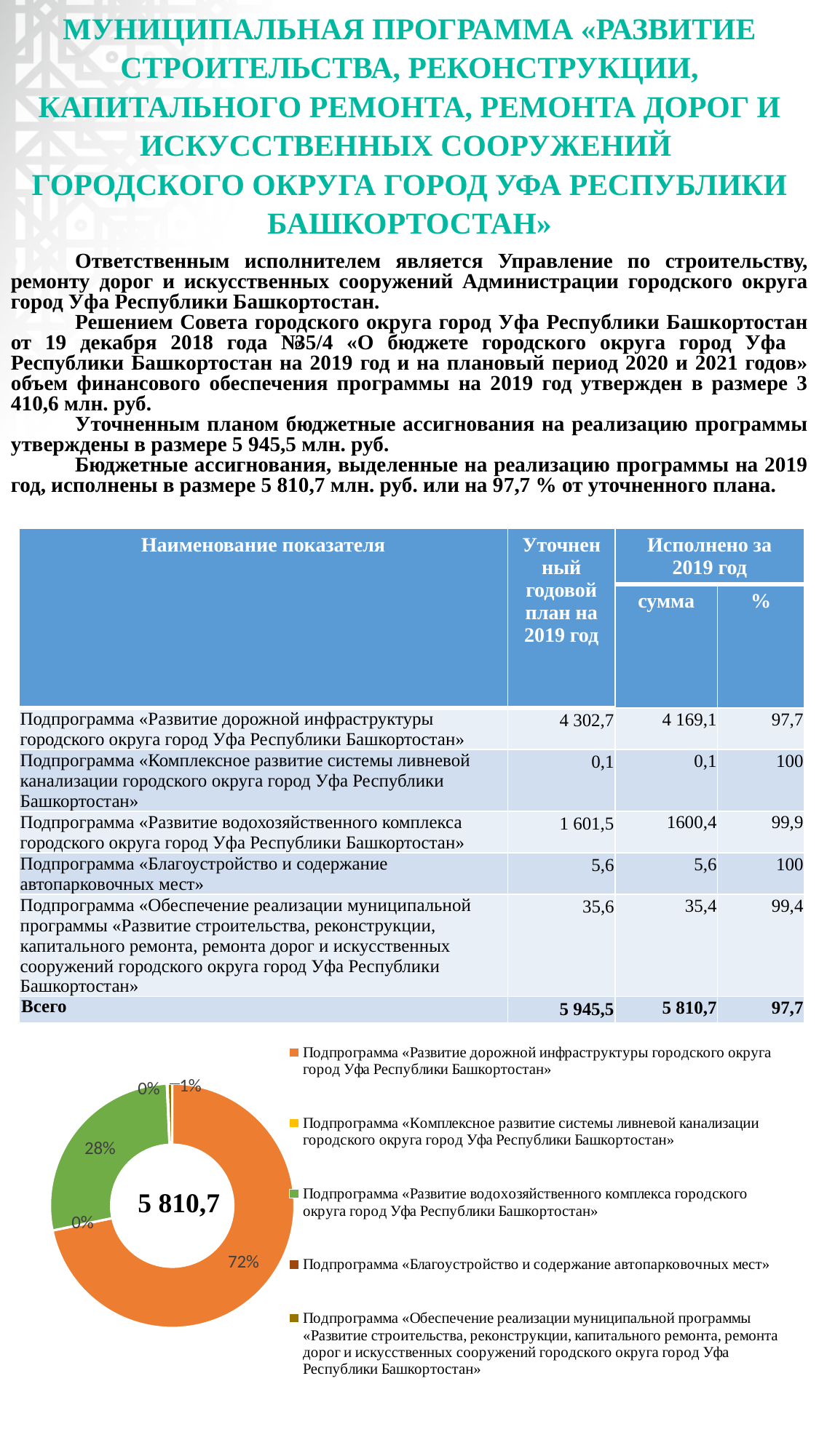
How many entries does the legend of the doughnut chart list? 5 Which slice is larger in the doughnut chart: the road infrastructure subprogram or the water management complex subprogram? the road infrastructure subprogram Which subprogram has the largest slice in the doughnut chart? Подпрограмма «Развитие дорожной инфраструктуры городского округа город Уфа Республики Башкортостан» What colour is the slice for the subprogram «Развитие дорожной инфраструктуры» in the doughnut chart? orange Is the share of the road infrastructure subprogram in the doughnut chart greater or less than 50%? greater What share of the doughnut chart does the subprogram «Развитие дорожной инфраструктуры городского округа город Уфа Республики Башкортостан» take? 72% What colour is the slice for the subprogram «Развитие водохозяйственного комплекса» in the doughnut chart? green What share of the doughnut chart does the subprogram «Развитие водохозяйственного комплекса городского округа город Уфа Республики Башкортостан» take? 28% What is the difference in percentage points between the 72% slice and the 28% slice in the doughnut chart? 44 percentage points What kind of chart is shown at the bottom of the slide? doughnut chart How many slices does the doughnut chart have according to its legend? 5 What value is printed in the centre of the doughnut chart? 5 810,7